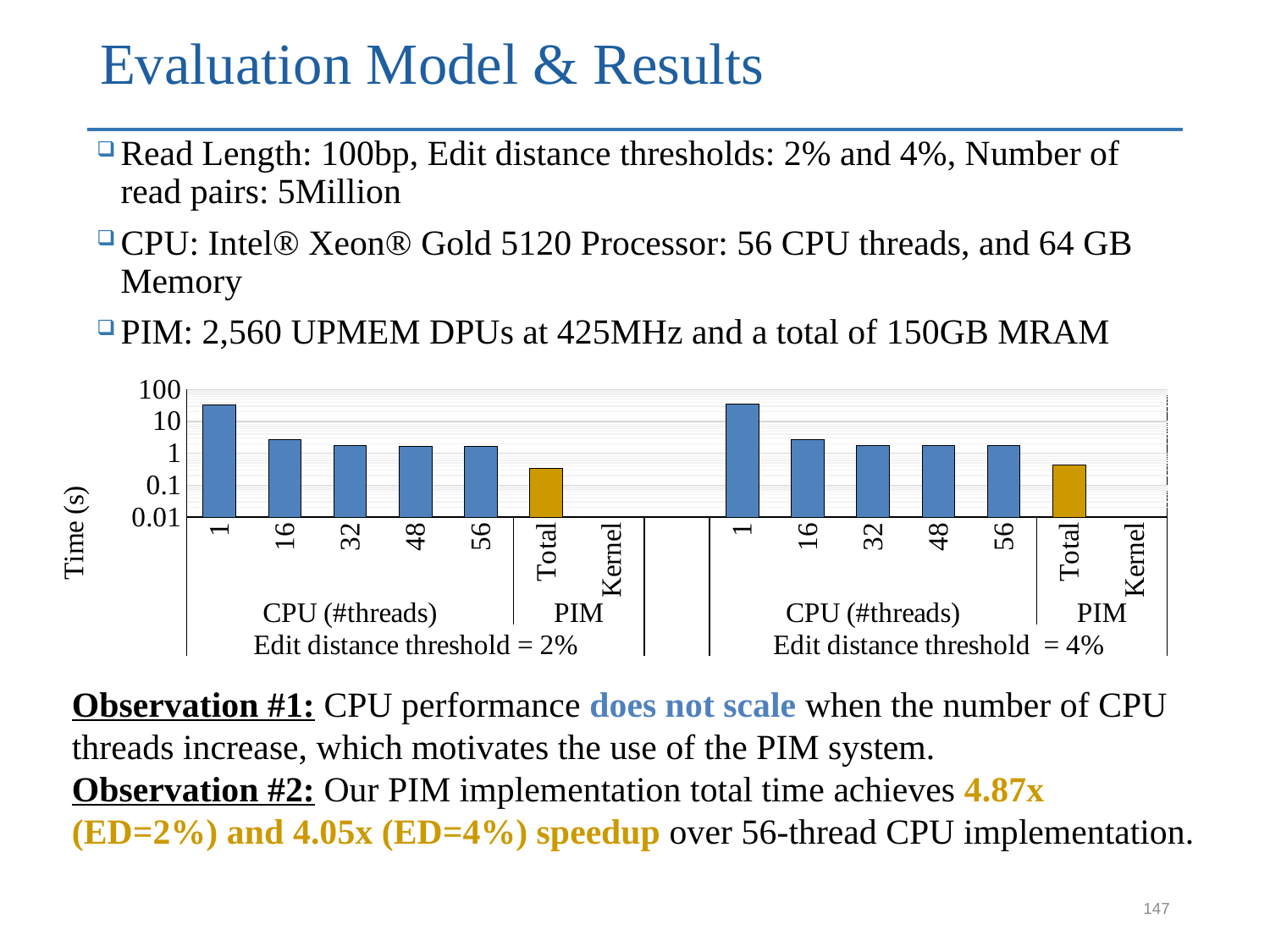
In the Edit distance threshold = 4% group, is the time for 16 CPU threads greater or less than 1 second? greater What are the two edit distance thresholds shown as groups on the x-axis of the chart? 2% and 4% In the Edit distance threshold = 4% group, which CPU thread count has the highest time? 1 In the Edit distance threshold = 2% group, which CPU thread count has the highest time? 1 How many CPU thread counts are plotted in each edit distance group of the chart? 5 In the Edit distance threshold = 2% group, is the PIM Total time greater or less than 1 second? less What is the label of the y-axis of the chart? Time (s) What kind of chart is shown on the slide? bar chart In the Edit distance threshold = 2% group, does the CPU time rise or fall as the number of threads increases from 1 to 56? fall In the Edit distance threshold = 2% group, is the time for 1 CPU thread greater or less than 10 seconds? greater In the Edit distance threshold = 4% group, which is larger: the time for 56 CPU threads or the PIM Total time? 56 CPU threads In the Edit distance threshold = 2% group, which is larger: the time for 1 CPU thread or the time for 56 CPU threads? 1 CPU thread